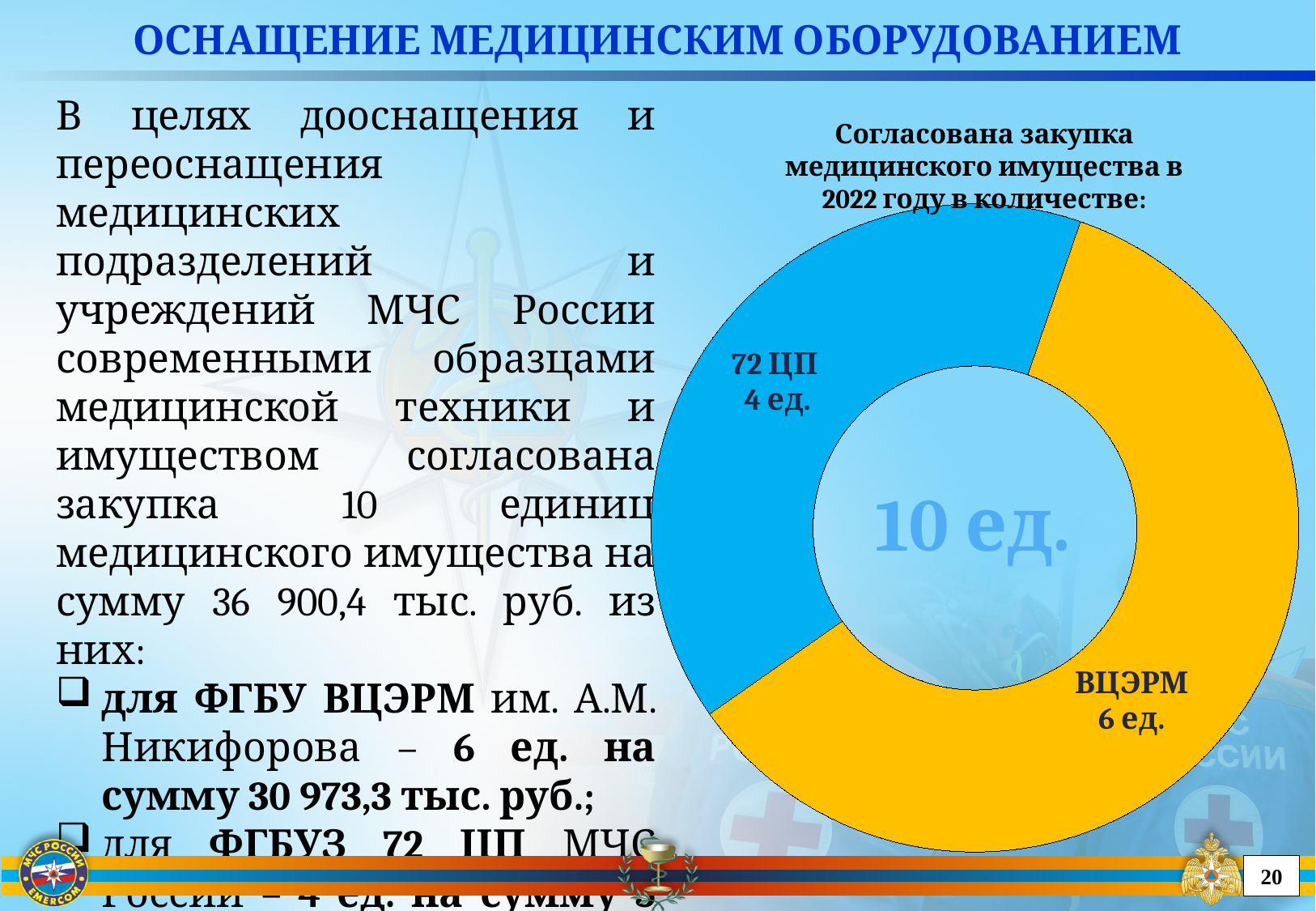
How many units are shown for ВЦЭРМ in the chart? 6 ед. What share of the total units does ВЦЭРМ account for? 60% Which is larger: the value for ВЦЭРМ or the value for 72 ЦП? ВЦЭРМ How many units are shown for 72 ЦП in the chart? 4 ед. What colour is the ВЦЭРМ slice in the chart? Yellow What is the difference in units between ВЦЭРМ and 72 ЦП? 2 ед. Which category has the smaller slice in the chart? 72 ЦП What kind of chart is shown on the slide? Doughnut (pie) chart What share of the total units does 72 ЦП account for? 40% What total number of units is shown in the centre of the chart? 10 ед. How many categories (slices) does the chart have? 2 Which category has the larger slice in the chart? ВЦЭРМ